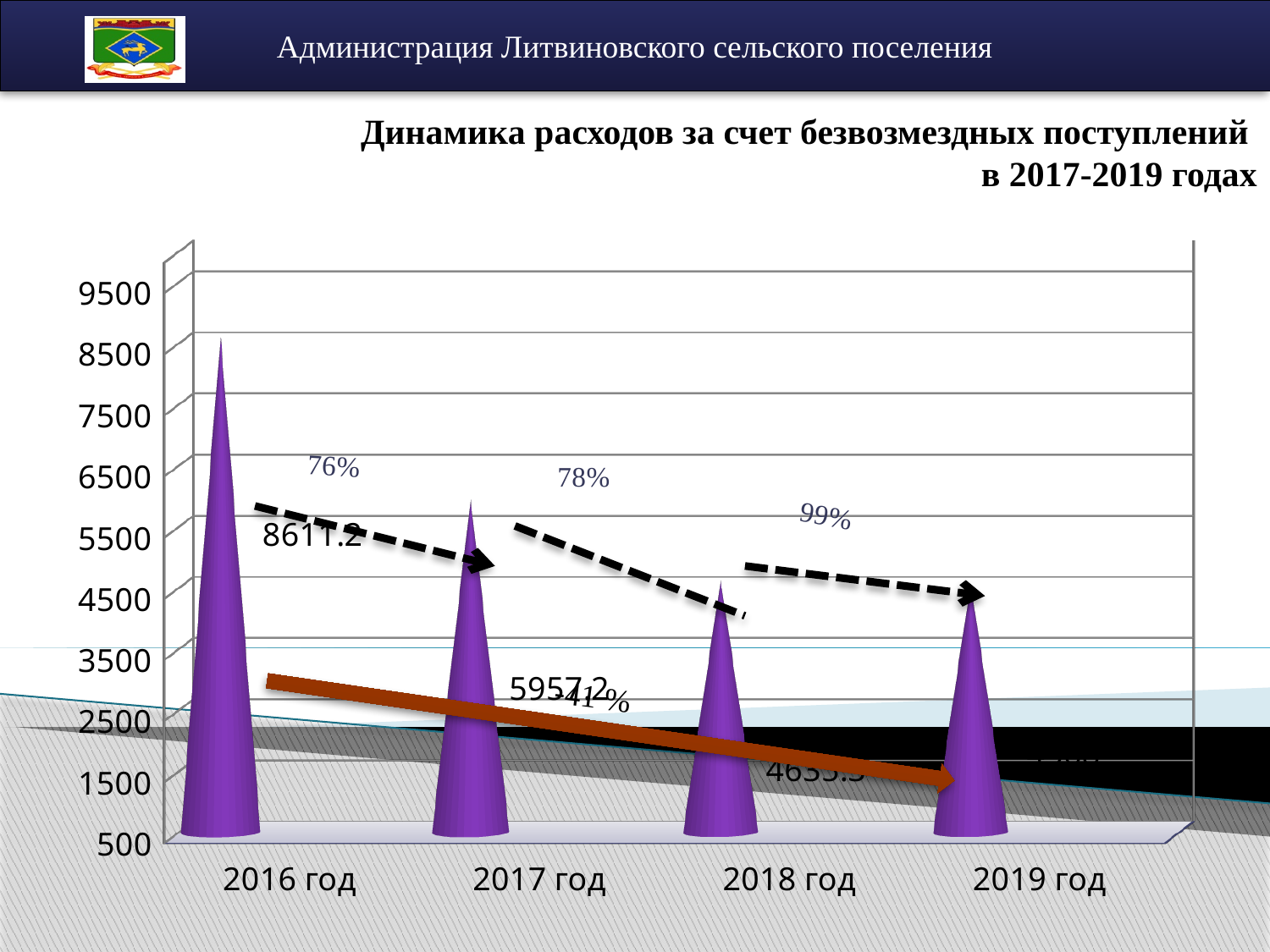
What colour are the bars on the chart? purple What kind of chart is shown on the slide? bar chart What is the difference between the values for 2016 год and 2017 год? 2654 Is the value for 2016 год greater or less than 7500? greater What is the value shown for 2017 год? 5957.2 Is the value for 2019 год greater or less than 6500? less Is the value for 2018 год greater or less than 5500? less Which year has the highest value on the chart? 2016 год Which is larger, the value for 2016 год or the value for 2017 год? 2016 год How many years (categories) are plotted on the chart? 4 What is the value shown for 2016 год? 8611.2 Do the values rise or fall from 2016 год to 2019 год? fall